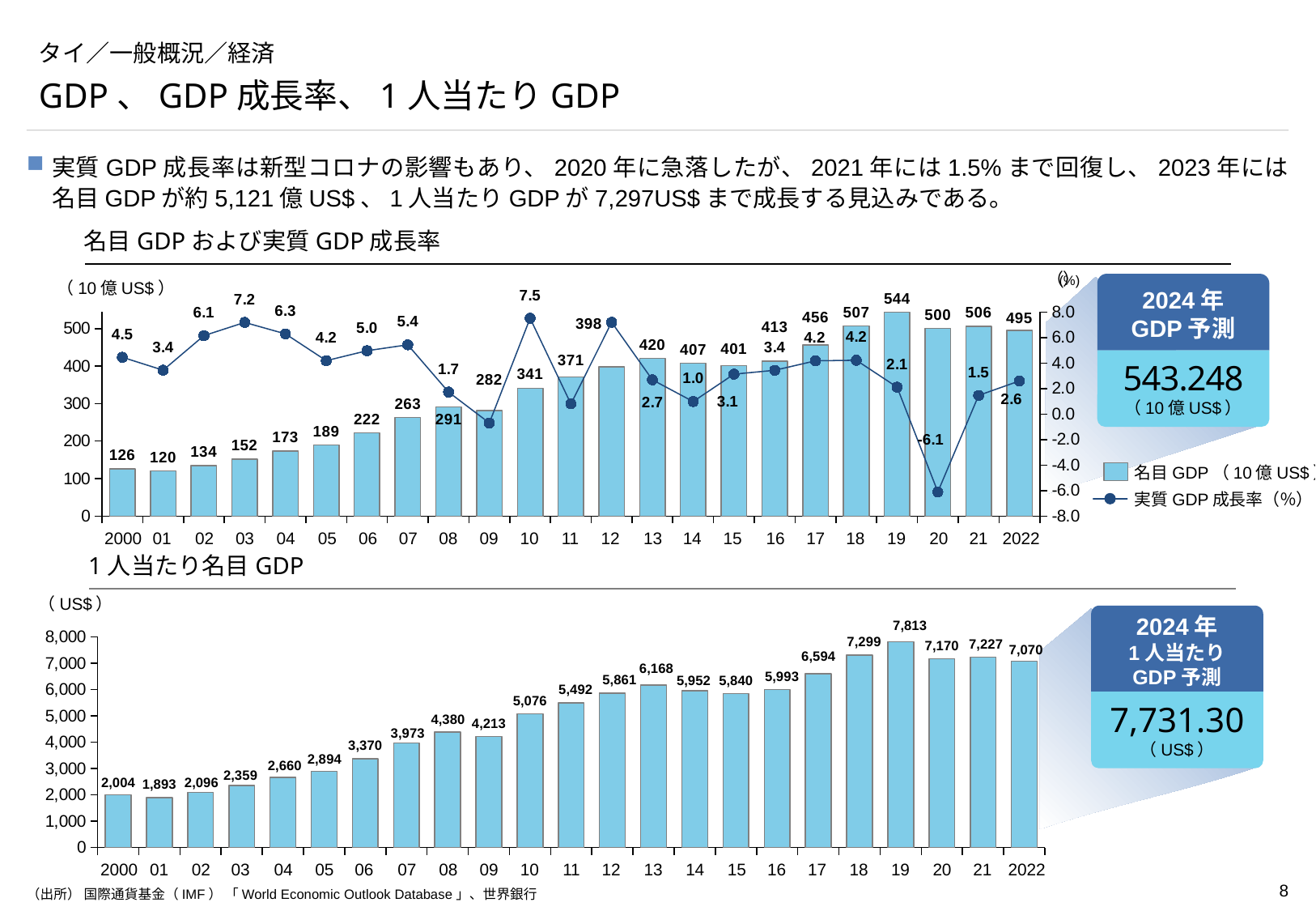
In the top chart (名目GDPおよび実質GDP成長率), what is the 2024 GDP forecast shown in the box? 543.248 In the top chart (名目GDPおよび実質GDP成長率), which year has the highest nominal GDP bar? 19 In the bottom chart (1人当たり名目GDP), what is the value for 2018? 7,299 In the bottom chart (1人当たり名目GDP), which year has the highest value? 19 In the top chart (名目GDPおよび実質GDP成長率), what is the nominal GDP value for 2019? 544 In the top chart (名目GDPおよび実質GDP成長率), what is the difference between the nominal GDP of 2022 and 2000? 369 In the top chart (名目GDPおよび実質GDP成長率), what is the real GDP growth rate for 2020? -6.1 In the top chart (名目GDPおよび実質GDP成長率), how many series does the legend list? 2 In the bottom chart (1人当たり名目GDP), which year has the lowest value? 01 What kind of chart is the bottom chart (1人当たり名目GDP)? bar chart In the bottom chart (1人当たり名目GDP), is the value for 2013 larger or the value for 2014? 2013 In the top chart (名目GDPおよび実質GDP成長率), which year has the lowest real GDP growth rate? 20